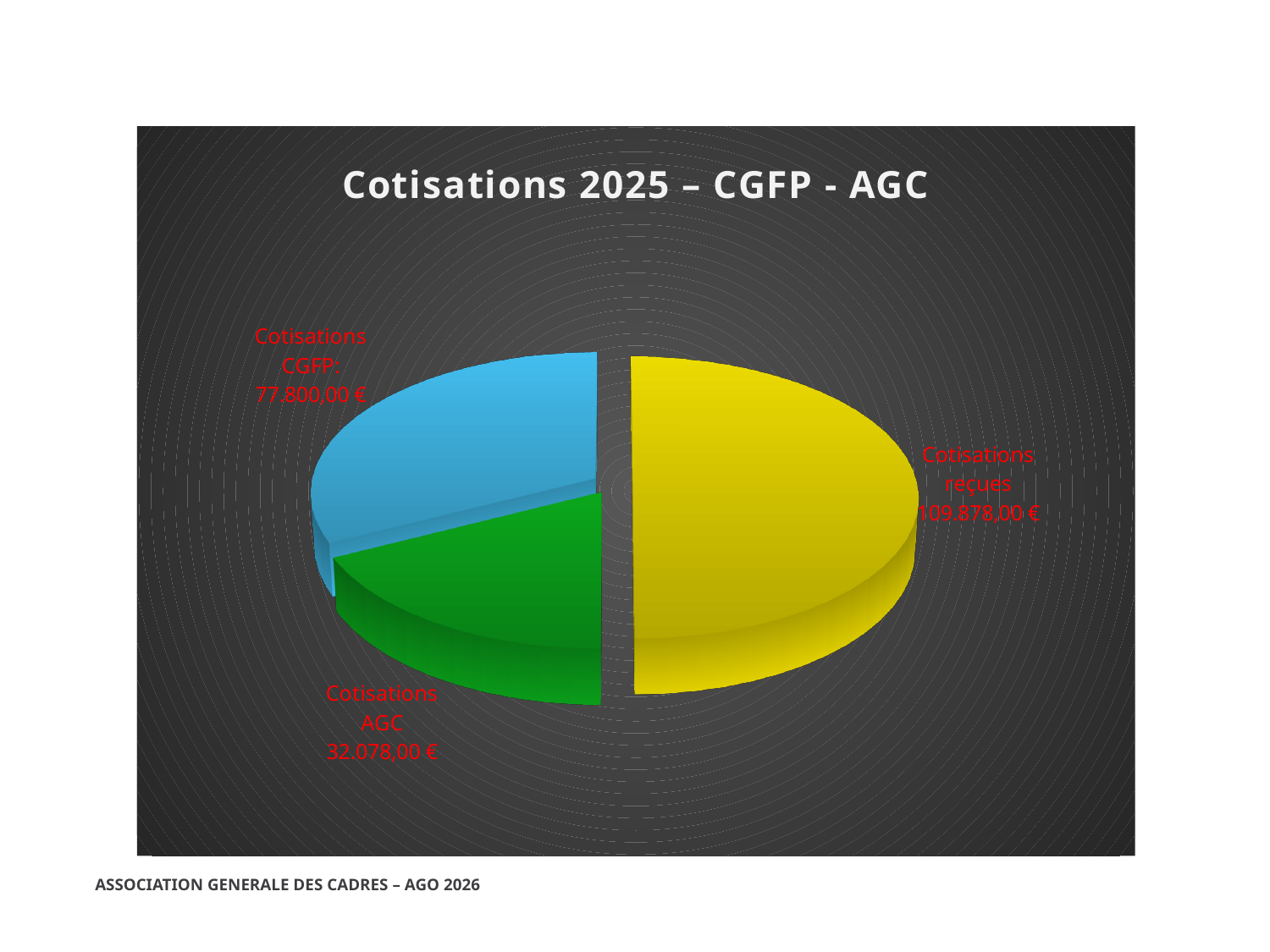
What share of the pie does the Cotisations reçues slice represent? 50% What is the value of the Cotisations CGFP slice? 77.800,00 € How many slices does the pie chart have? 3 What is the title of the chart? Cotisations 2025 – CGFP - AGC What is the value of the Cotisations AGC slice? 32.078,00 € What kind of chart is shown on the slide? Pie chart Which slice has the smallest value? Cotisations AGC Which slice has the largest value? Cotisations reçues Which is larger, Cotisations CGFP or Cotisations AGC? Cotisations CGFP What is the difference between Cotisations CGFP and Cotisations AGC? 45.722,00 € What is the difference between Cotisations reçues and Cotisations CGFP? 32.078,00 € What is the value of the Cotisations reçues slice? 109.878,00 €